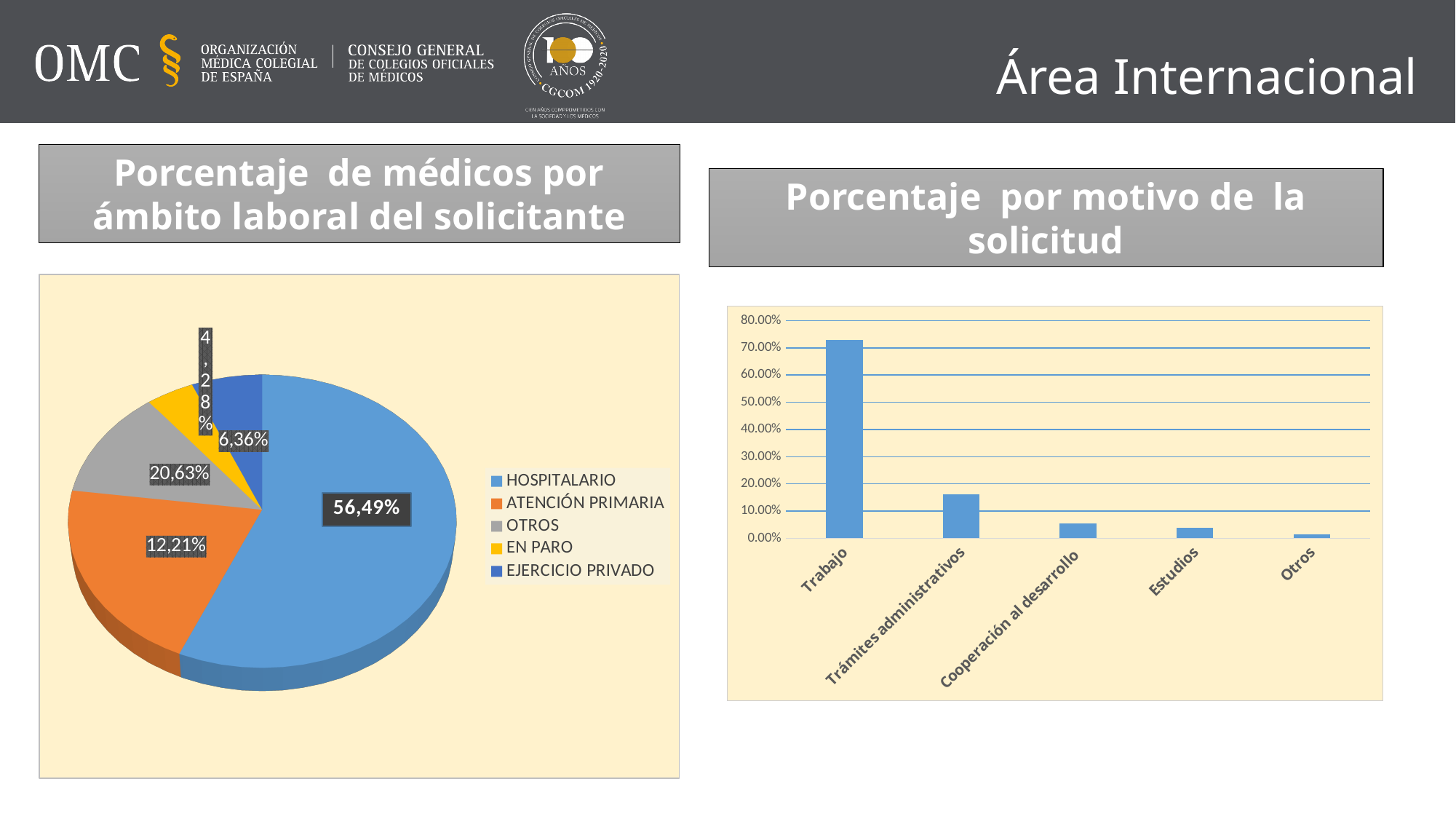
In the pie chart 'Porcentaje de médicos por ámbito laboral del solicitante', which category has the largest share? HOSPITALARIO In the pie chart 'Porcentaje de médicos por ámbito laboral del solicitante', what percentage is shown for EJERCICIO PRIVADO? 6,36% In the chart 'Porcentaje por motivo de la solicitud', is the value for Trabajo greater or less than 70.00%? greater In the pie chart 'Porcentaje de médicos por ámbito laboral del solicitante', what percentage is shown for OTROS? 20,63% In the pie chart 'Porcentaje de médicos por ámbito laboral del solicitante', what percentage is shown for ATENCIÓN PRIMARIA? 12,21% In the pie chart 'Porcentaje de médicos por ámbito laboral del solicitante', what percentage is shown for HOSPITALARIO? 56,49% In the chart 'Porcentaje por motivo de la solicitud', how many categories are shown on the x axis? 5 In the chart 'Porcentaje por motivo de la solicitud', which category has the highest value? Trabajo In the pie chart 'Porcentaje de médicos por ámbito laboral del solicitante', how many categories does the legend list? 5 In the chart 'Porcentaje por motivo de la solicitud', what kind of chart is shown? Bar chart In the pie chart 'Porcentaje de médicos por ámbito laboral del solicitante', which category has the smallest share? EN PARO